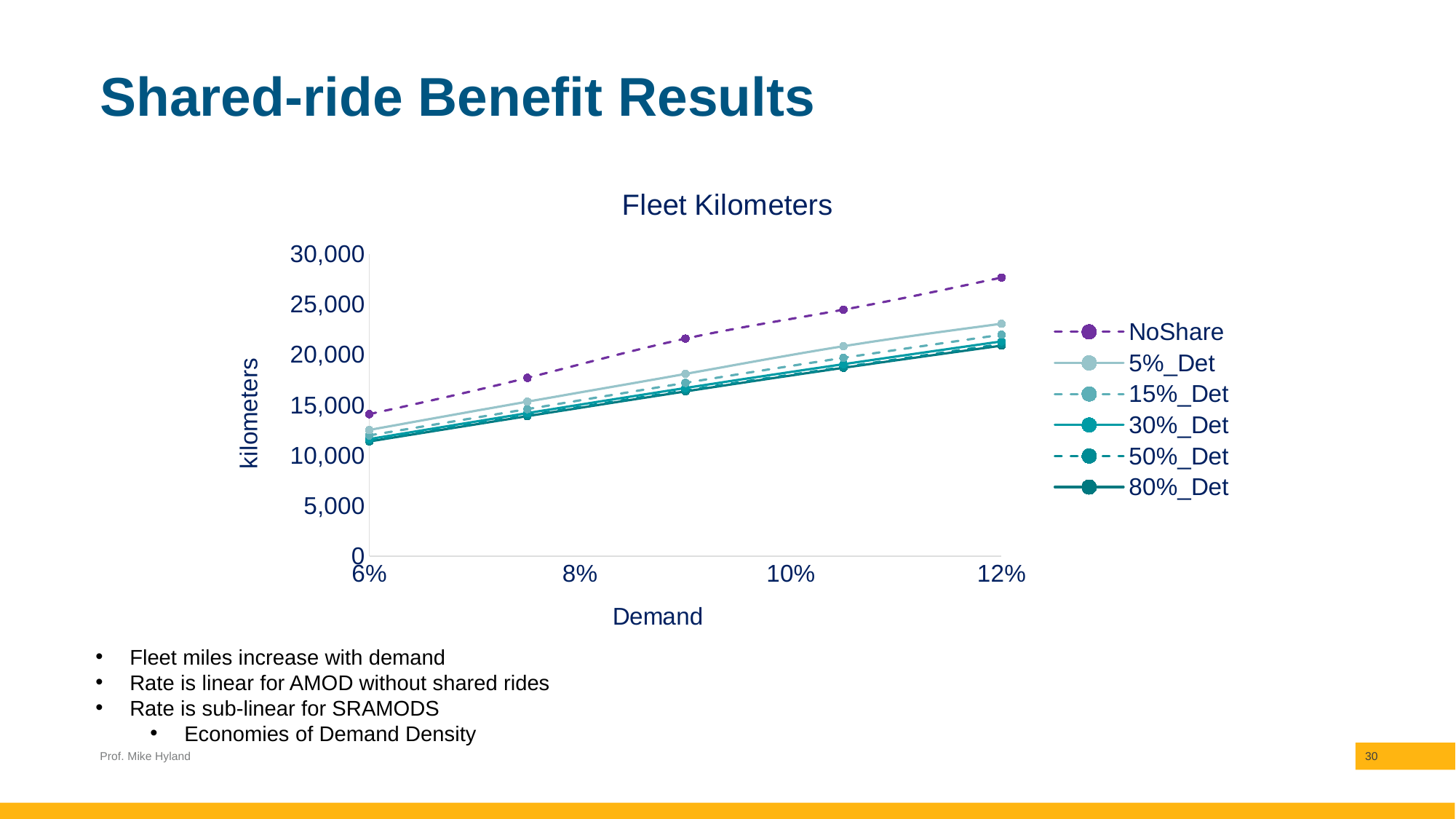
How many data points are plotted for the NoShare series? 5 Is the 80%_Det value at 6% demand greater or less than 10,000? greater Is the NoShare value at 6% demand greater or less than 15,000? less What is the label of the vertical axis of the chart? kilometers Do the fleet kilometers for the NoShare series rise or fall as demand increases along the x axis? rise At 12% demand, which series has higher fleet kilometers, NoShare or 5%_Det? NoShare Is the NoShare value at 12% demand greater or less than 25,000? greater What is the title of the chart? Fleet Kilometers Which series has the highest fleet kilometers at 12% demand? NoShare How many series does the legend of the Fleet Kilometers chart list? 6 What kind of chart is shown on the slide? line chart